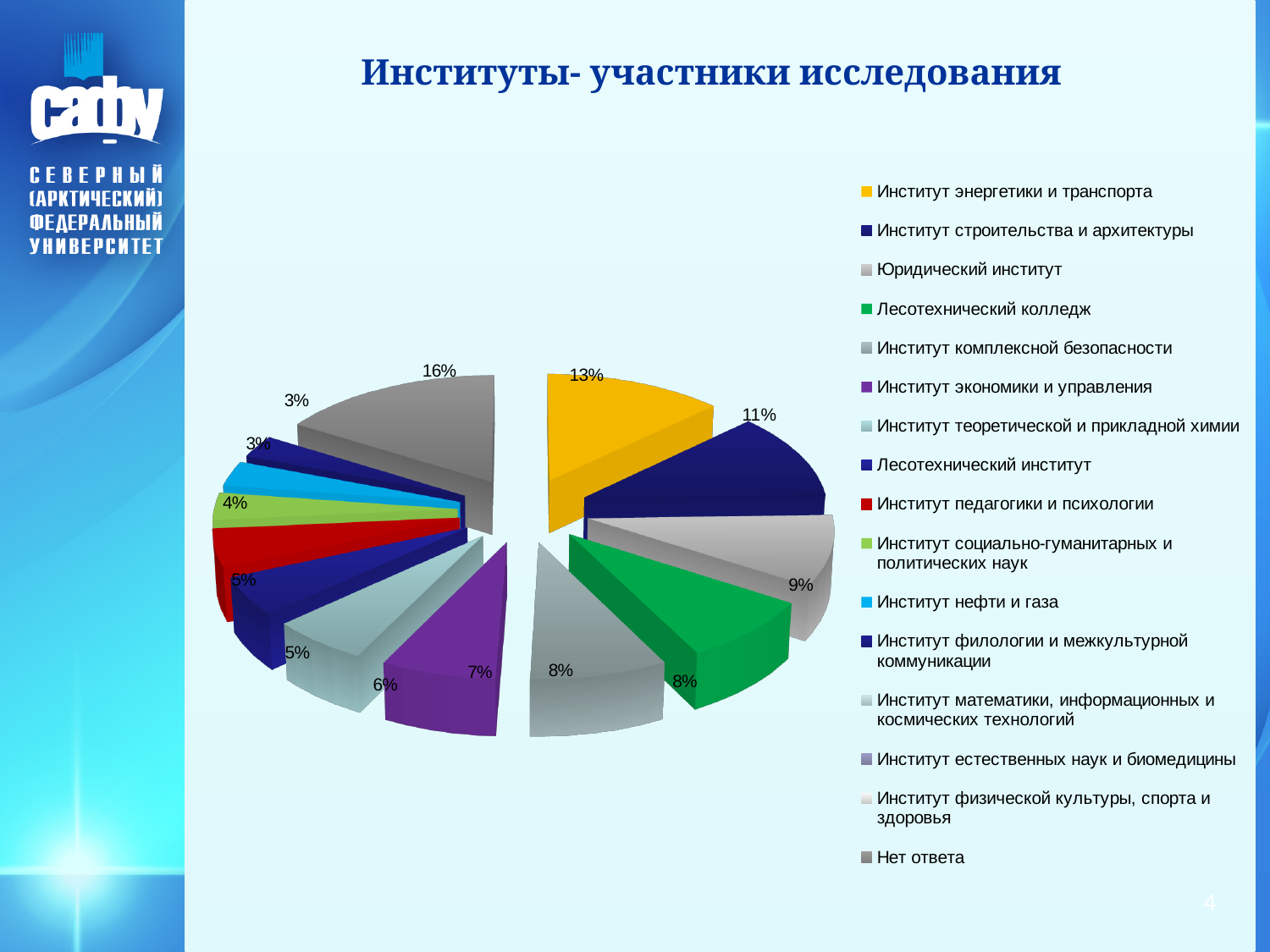
What share of the pie does Институт энергетики и транспорта (yellow slice) have? 13% How many entries does the legend of the pie chart list? 16 What share of the pie does Институт педагогики и психологии (red slice) have? 5% Which slice has the largest share of the pie? Нет ответа (16%) What is the title of the chart on the slide? Институты- участники исследования What kind of chart is shown on the slide? pie chart What share of the pie does Юридический институт have? 9% What is the difference between the share of Институт энергетики и транспорта (13%) and the share of Юридический институт (9%)? 4% Which is larger: the share of Институт энергетики и транспорта or the share of Институт строительства и архитектуры? Институт энергетики и транспорта